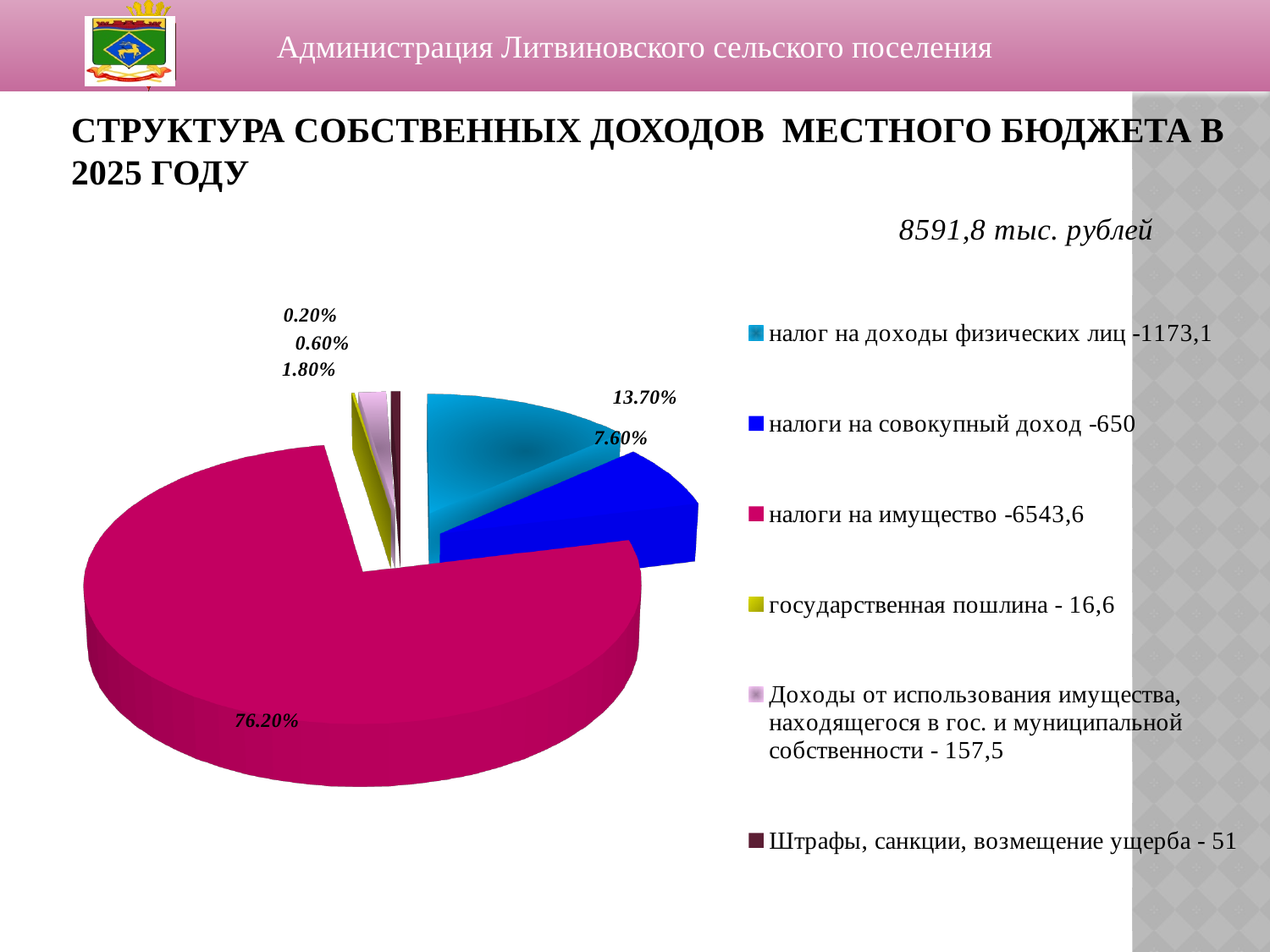
Which category has the smallest value according to the legend? государственная пошлина What value is given in the legend for "налоги на имущество"? 6543,6 What share of the pie does "налог на доходы физических лиц" take? 13.70% What share of the pie does "налоги на имущество" take? 76.20% What kind of chart is shown on the slide? pie chart What total amount is stated above the chart? 8591,8 тыс. рублей What share of the pie does "налоги на совокупный доход" take? 7.60% Which is larger, "налог на доходы физических лиц" or "налоги на совокупный доход"? налог на доходы физических лиц Which category has the largest slice of the pie? налоги на имущество What value is given in the legend for "государственная пошлина"? 16,6 How many slices does the pie chart have? 6 What is the difference between the legend values for "налог на доходы физических лиц" (1173,1) and "налоги на совокупный доход" (650)? 523,1